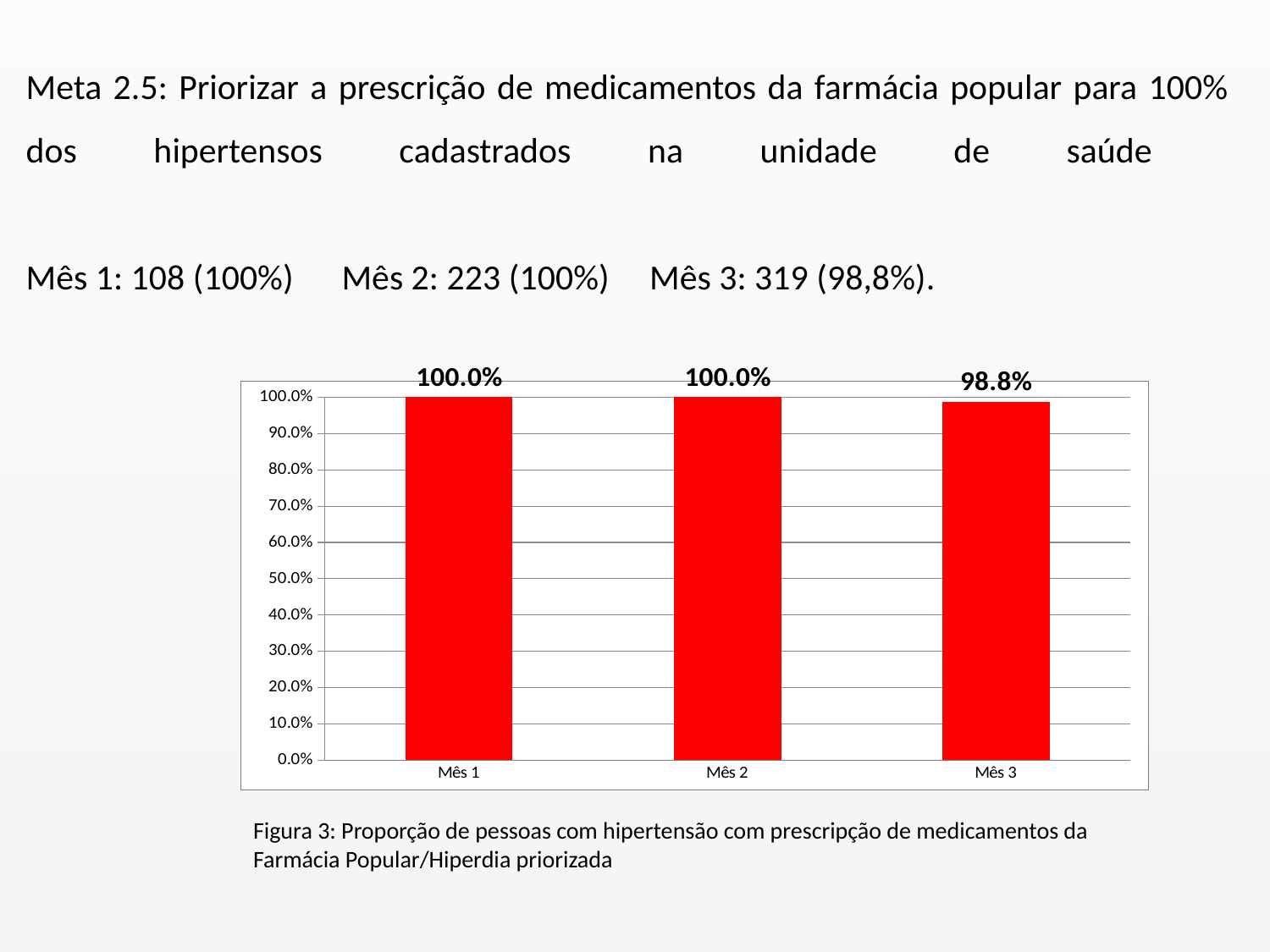
Which is larger, the value for Mês 2 or the value for Mês 3? Mês 2 What is the difference between the values for Mês 1 and Mês 3? 1.2% Which month has the lowest value? Mês 3 What is the figure number given in the caption below the chart? Figura 3 What colour are the bars in the chart? red What is the value for Mês 2? 100.0% What is the value for Mês 1? 100.0% What is the value for Mês 3? 98.8% How many categories are shown on the x axis? 3 What kind of chart is shown on the slide? bar chart Is the value for Mês 3 greater or less than 90.0%? greater Do the values rise or fall from Mês 2 to Mês 3? fall